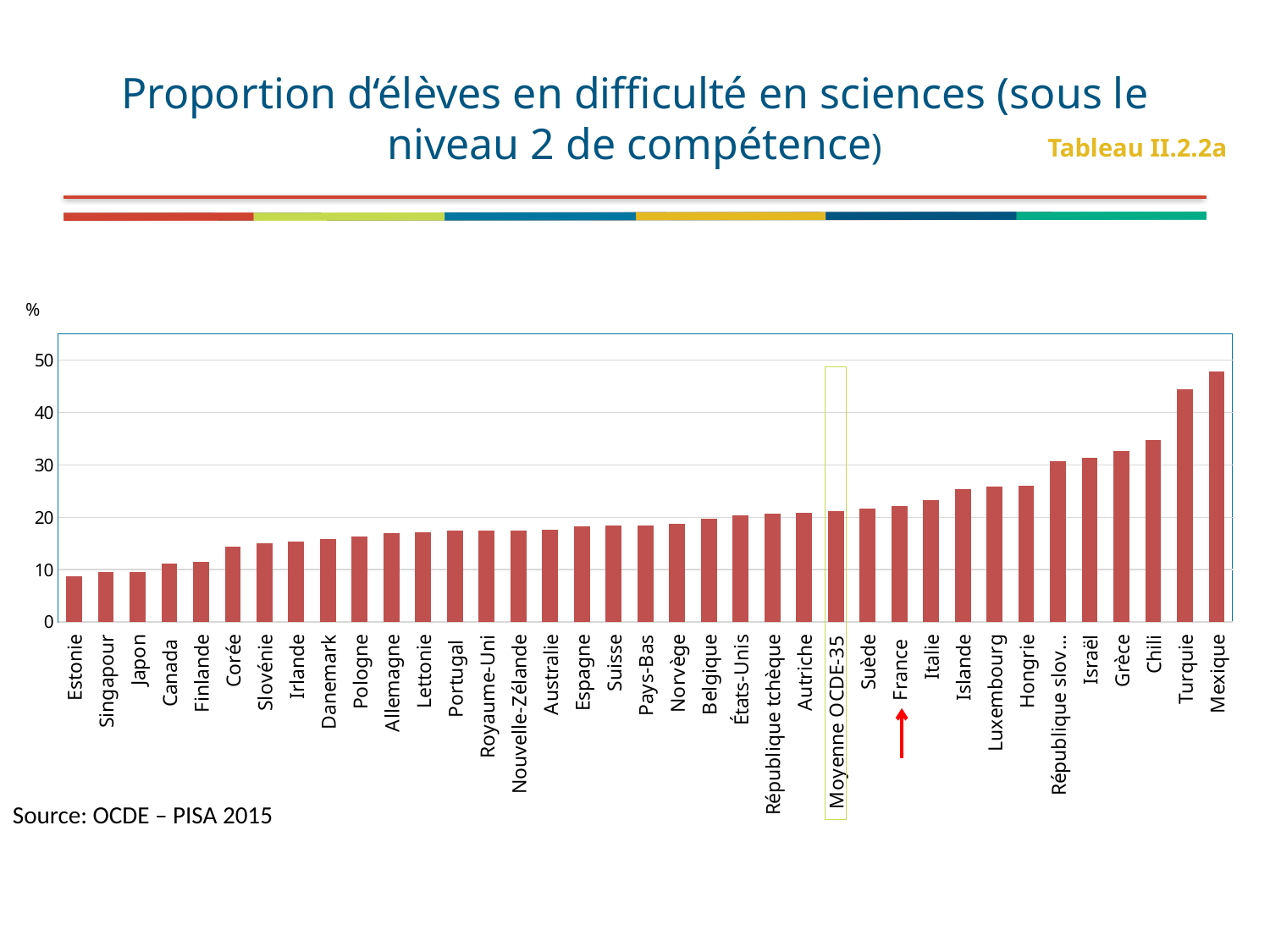
Is the value for Chili greater or less than 30? greater Which category has the highest proportion of students in difficulty in sciences? Mexique Is the value for Estonie greater or less than 10? less Which has a higher value, Turquie or Chili? Turquie Do the values rise or fall from left to right along the x axis? rise Is the value for Hongrie greater or less than 30? less How many categories are plotted on the chart? 37 Which has a higher value, France or Estonie? France What kind of chart is shown on the slide? bar chart Which category is marked with a red arrow below the chart? France